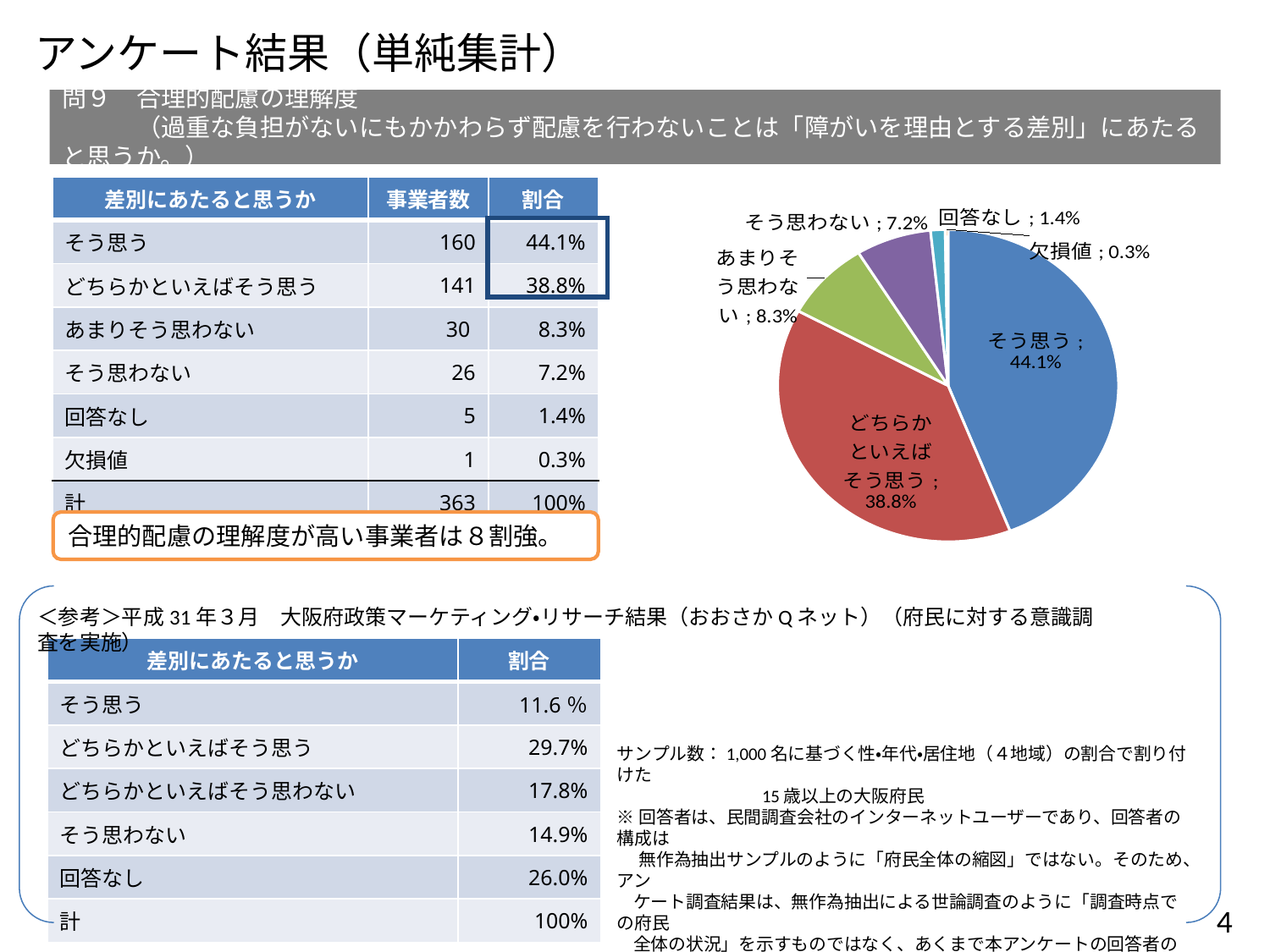
What is the share shown for あまりそう思わない in the pie chart? 8.3% Which slice of the pie chart is the smallest? 欠損値 What is the share shown for どちらかといえばそう思う in the pie chart? 38.8% What is the share shown for そう思う in the pie chart? 44.1% What is the difference in percentage points between そう思う and どちらかといえばそう思う in the pie chart? 5.3 What colour is the そう思う slice in the pie chart? blue In the pie chart, which is larger: あまりそう思わない or そう思わない? あまりそう思わない Which slice of the pie chart is the largest? そう思う What kind of chart is shown on the slide? pie chart What is the share shown for そう思わない in the pie chart? 7.2% How many slices does the pie chart have? 6 What is the share shown for 回答なし in the pie chart? 1.4%